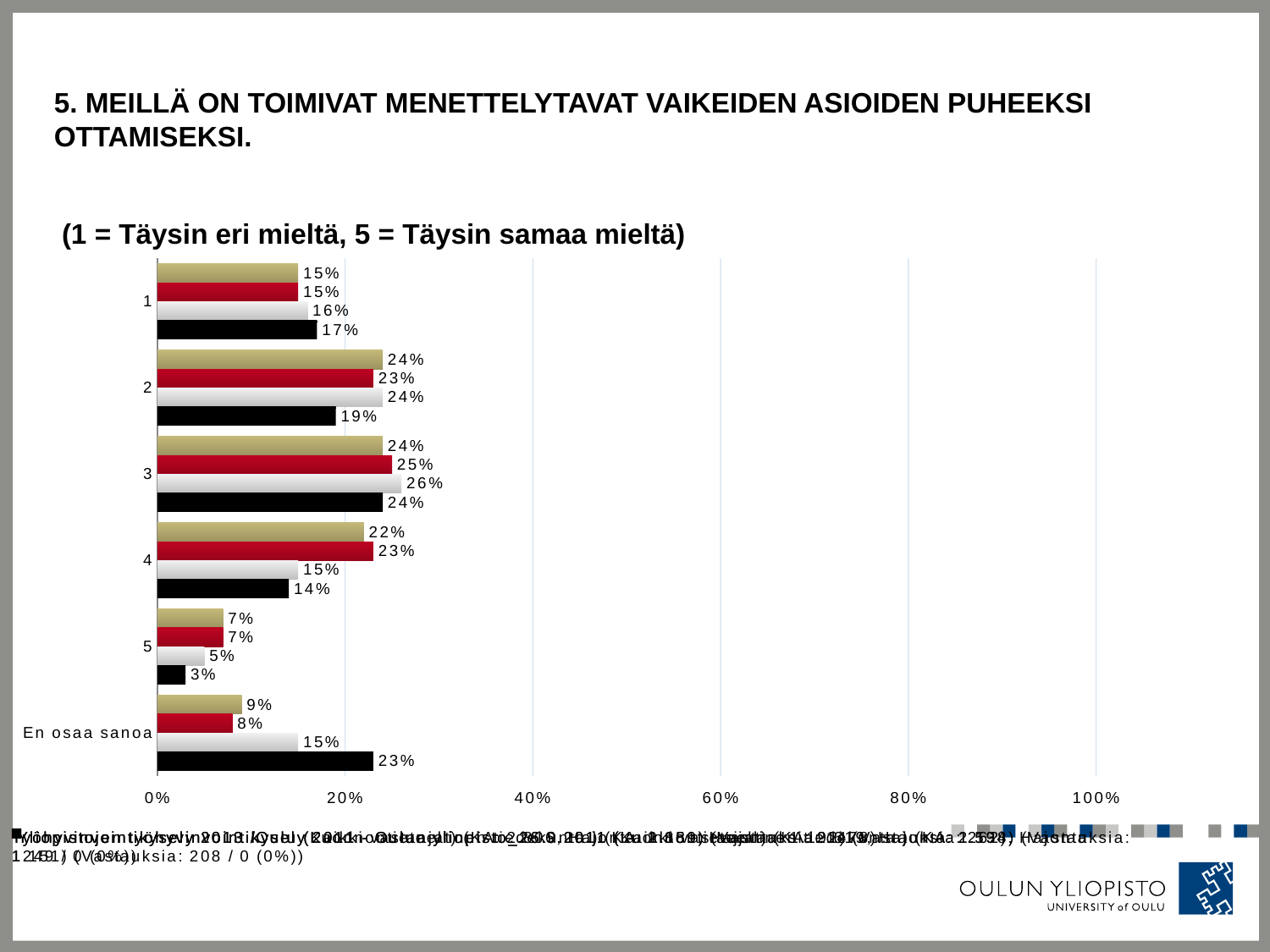
How many bars are shown for each category? 4 What is the value of the black bar for the category "En osaa sanoa"? 23% What is the value of the light gray bar for category 1? 16% What type of chart is shown on the slide? Bar chart How many categories are shown on the vertical axis of the chart? 6 What is the value of the gold (tan) bar for category 4? 22% Among the light gray bars, which category has the lowest value? 5 Among the red bars, which category has the highest value? 3 For category 4, which is larger: the red bar or the light gray bar? The red bar Is the value of the light gray bar for category 3 greater or less than 20%? greater For category 2, what is the difference between the gold (tan) bar and the black bar? 5 percentage points What is the value of the red bar for category 3? 25%